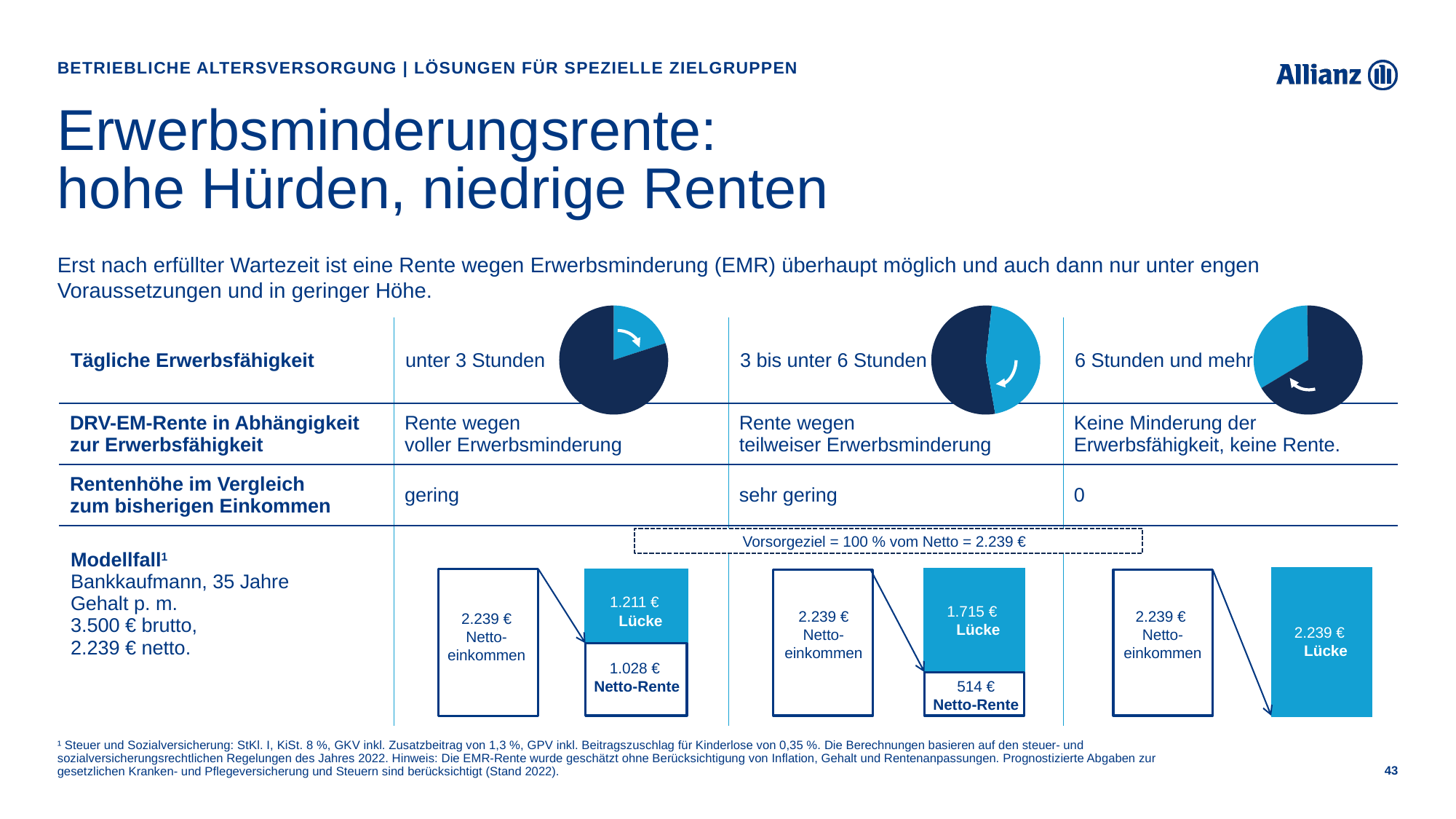
Of the two scenarios that show a Netto-Rente, which has the lower Netto-Rente? 3 bis unter 6 Stunden In the bar chart for '3 bis unter 6 Stunden', what is the Lücke? 1.715 € In the bar chart for 'unter 3 Stunden', what is the Netto-Rente? 1.028 € Which of the three scenarios shows the largest Lücke? 6 Stunden und mehr In the bar chart for '6 Stunden und mehr', what is the Lücke? 2.239 € In the bar chart for '3 bis unter 6 Stunden', which is larger, the Lücke or the Netto-Rente? Lücke What is the Netto-Rente in the 'unter 3 Stunden' chart minus the Netto-Rente in the '3 bis unter 6 Stunden' chart? 514 € In the bar chart for 'unter 3 Stunden', what is the total of Lücke and Netto-Rente? 2.239 € In the bar chart for '3 bis unter 6 Stunden', what is the Netto-Rente? 514 € In the bar chart for 'unter 3 Stunden', how much larger is the Lücke than the Netto-Rente? 183 € How much larger is the Lücke in the '3 bis unter 6 Stunden' chart than in the 'unter 3 Stunden' chart? 504 € What Vorsorgeziel value is shown in the dashed box above the bar charts? 2.239 €